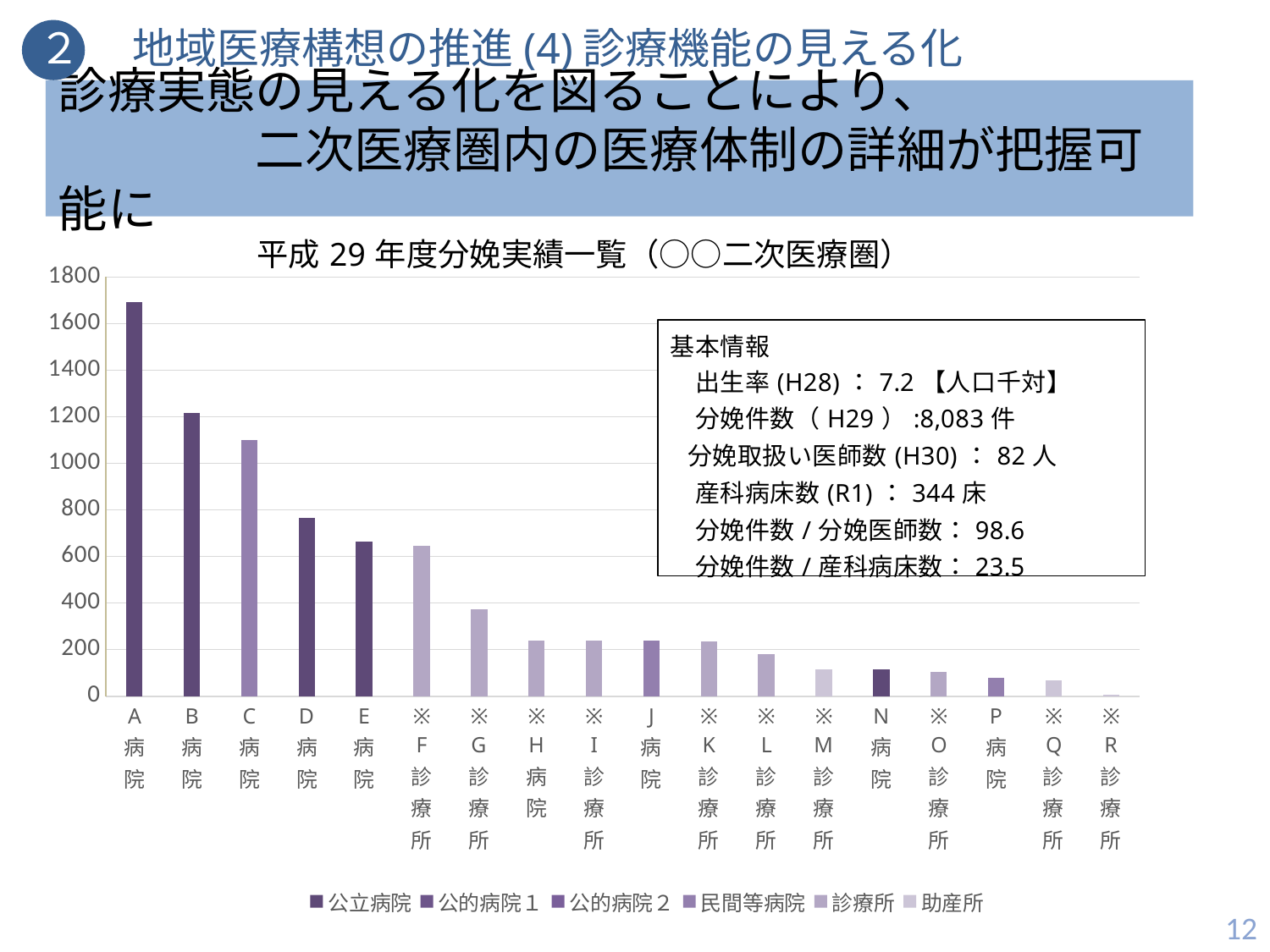
Which category has the lowest value in the chart? ※R診療所 Is the value for ※G診療所 greater or less than 400? less What is the title of the chart? 平成29年度分娩実績一覧（○○二次医療圏） What kind of chart is shown on the slide? bar chart Do the values generally rise or fall moving from left to right along the x axis? fall Which category has the highest value in the chart? A病院 Is the value for C病院 greater or less than 1000? greater How many series does the chart's legend list? 6 Is the value for A病院 greater or less than 1600? greater Which has a larger value, A病院 or B病院? A病院 How many categories are plotted along the x axis of the chart? 18